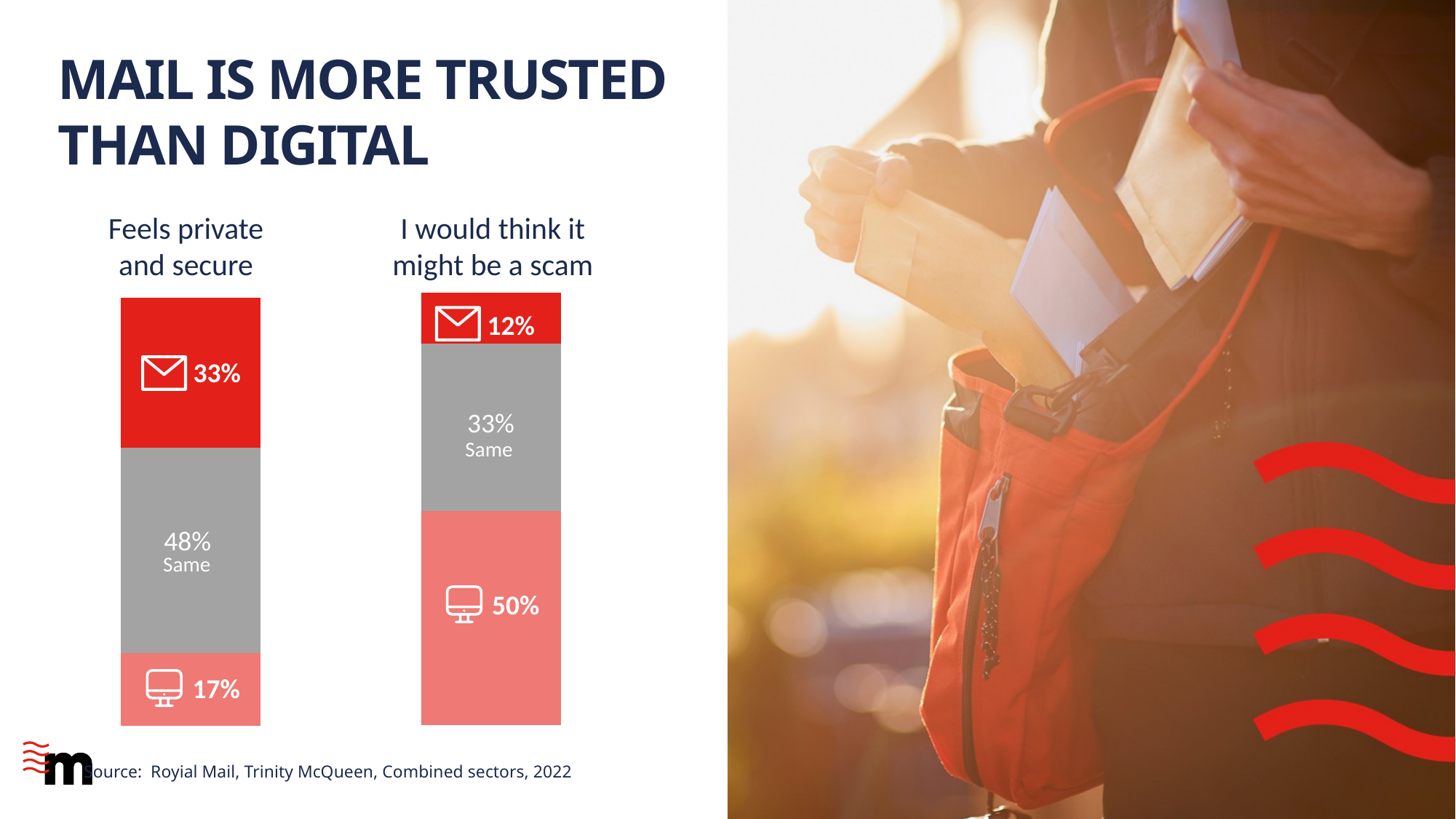
What is the difference between the mail and digital percentages in the 'Feels private and secure' bar? 16% In the 'I would think it might be a scam' bar, what percentage is labelled 'Same'? 33% What is the difference between the digital and mail percentages in the 'I would think it might be a scam' bar? 38% Which segment is the smallest in the 'Feels private and secure' bar? Digital (17%) In the 'Feels private and secure' bar, what percentage is shown for the mail (envelope) segment? 33% In the 'I would think it might be a scam' bar, what percentage is shown for the digital (computer) segment? 50% In the 'Feels private and secure' bar, what percentage is shown for the digital (computer) segment? 17% In the 'I would think it might be a scam' bar, what percentage is shown for the mail (envelope) segment? 12% What type of chart is shown on the slide? Stacked bar chart Which is larger in the 'Feels private and secure' bar: the mail segment or the digital segment? Mail Which segment is the largest in the 'I would think it might be a scam' bar? Digital (50%) In the 'Feels private and secure' bar, what percentage is labelled 'Same'? 48%